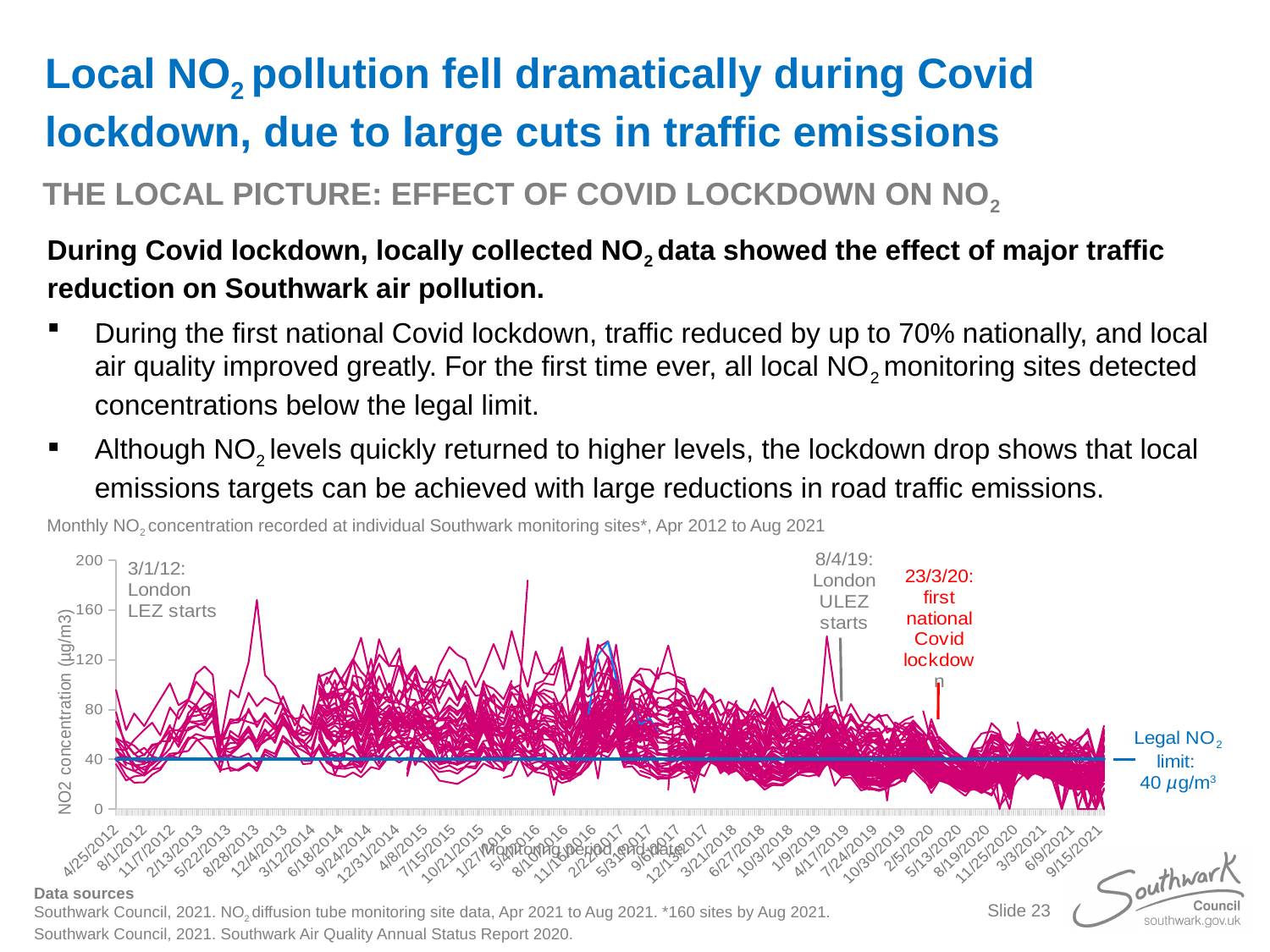
Which peak is higher: the spike around 2016 or the spike around 8/28/2013? the spike around 2016 What value is the legal NO2 limit line drawn at on the chart? 40 µg/m³ From 2016 to 2021, do the NO2 concentrations generally rise or fall? fall What is the title of the chart? Monthly NO2 concentration recorded at individual Southwark monitoring sites*, Apr 2012 to Aug 2021 Are the monitoring site values in mid-2021 greater or less than 120? less Around the first national Covid lockdown in 2020, are the lowest site values greater or less than 40? less Is the highest peak on the chart, around 2016, greater or less than 160? greater What kind of chart is shown on the slide? line chart What event is annotated on the chart at 23/3/20? first national Covid lockdown